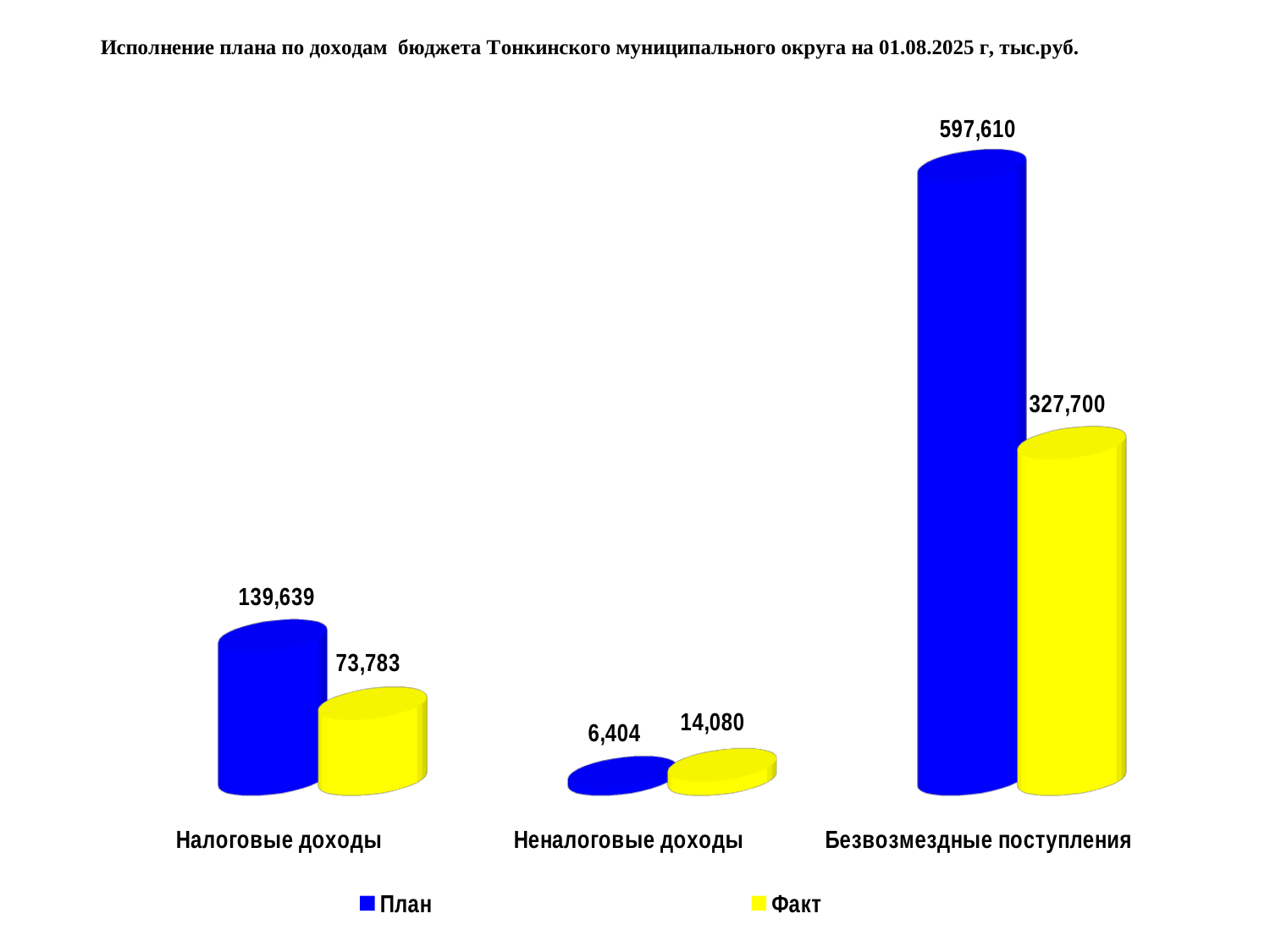
How many categories are shown on the x axis? 3 What is the Факт value for Безвозмездные поступления? 327,700 What is the План value for Неналоговые доходы? 6,404 What is the difference between the План and Факт values for Безвозмездные поступления? 269,910 Which category has the lowest Факт value? Неналоговые доходы How many series does the legend list? 2 What is the difference between the План and Факт values for Налоговые доходы? 65,856 What kind of chart is shown on the slide? Bar chart What is the Факт value for Неналоговые доходы? 14,080 What is the План value for Налоговые доходы? 139,639 Which category has the highest План value? Безвозмездные поступления For Неналоговые доходы, which is larger: План or Факт? Факт